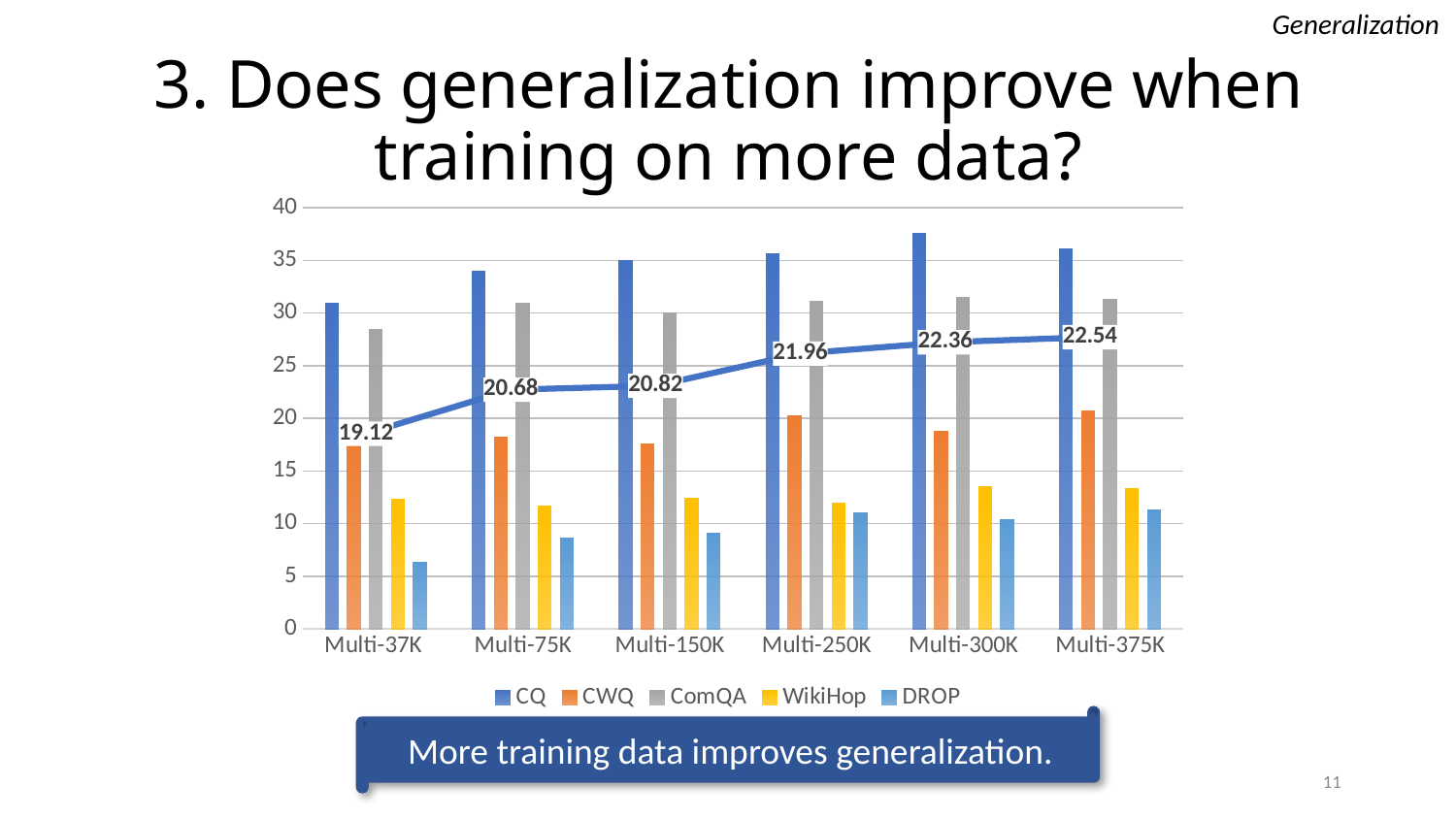
What value is labelled on the line at Multi-37K? 19.12 Do the labelled line values rise or fall from Multi-37K to Multi-375K? rise Which category has the lowest DROP bar? Multi-37K Is the CQ value for Multi-300K greater or less than 35? greater Is the DROP value for Multi-37K greater or less than 10? less What value is labelled on the line at Multi-375K? 22.54 How many series does the legend list? 5 What value is labelled on the line at Multi-250K? 21.96 At which category does the labelled line reach its highest value? Multi-375K How many categories are shown on the x axis? 6 What is the difference between the line values at Multi-375K and Multi-37K? 3.42 At which category does the labelled line have its lowest value? Multi-37K